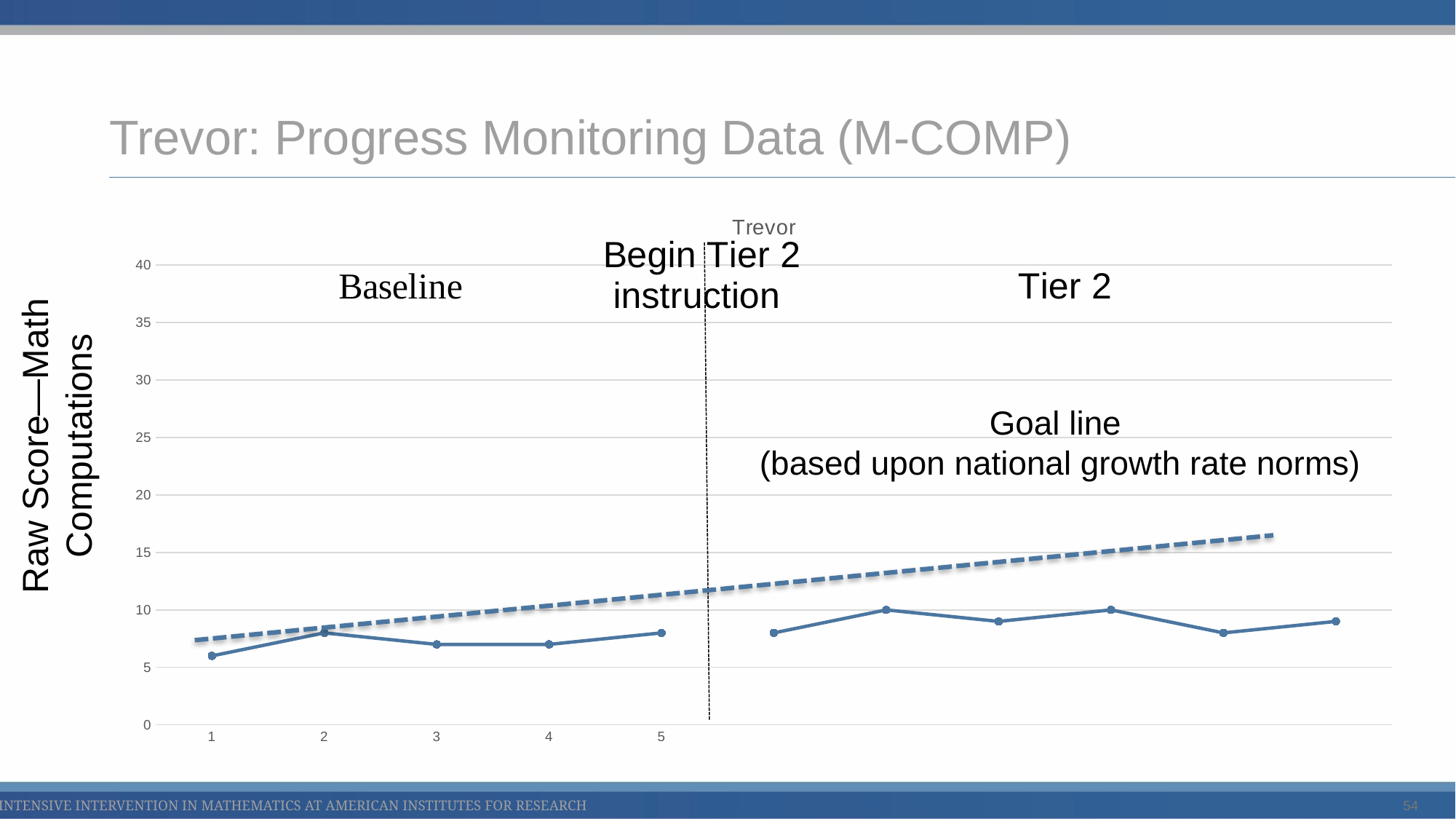
Which is larger, the value at point 1 or the value at point 2? point 2 Is the right end of the goal line greater or less than 15? greater Does the goal line rise or fall from left to right? rise What kind of chart is shown on the slide? line chart Is the value at point 3 greater or less than 10? less Is the value at point 1 greater or less than 10? less How many numbered points are labeled on the x axis? 5 How many data points are plotted in the Baseline phase? 5 What is the title printed above the chart? Trevor Which numbered point in the Baseline phase has the lowest value? 1 What does the dashed line on the chart represent? Goal line (based upon national growth rate norms)